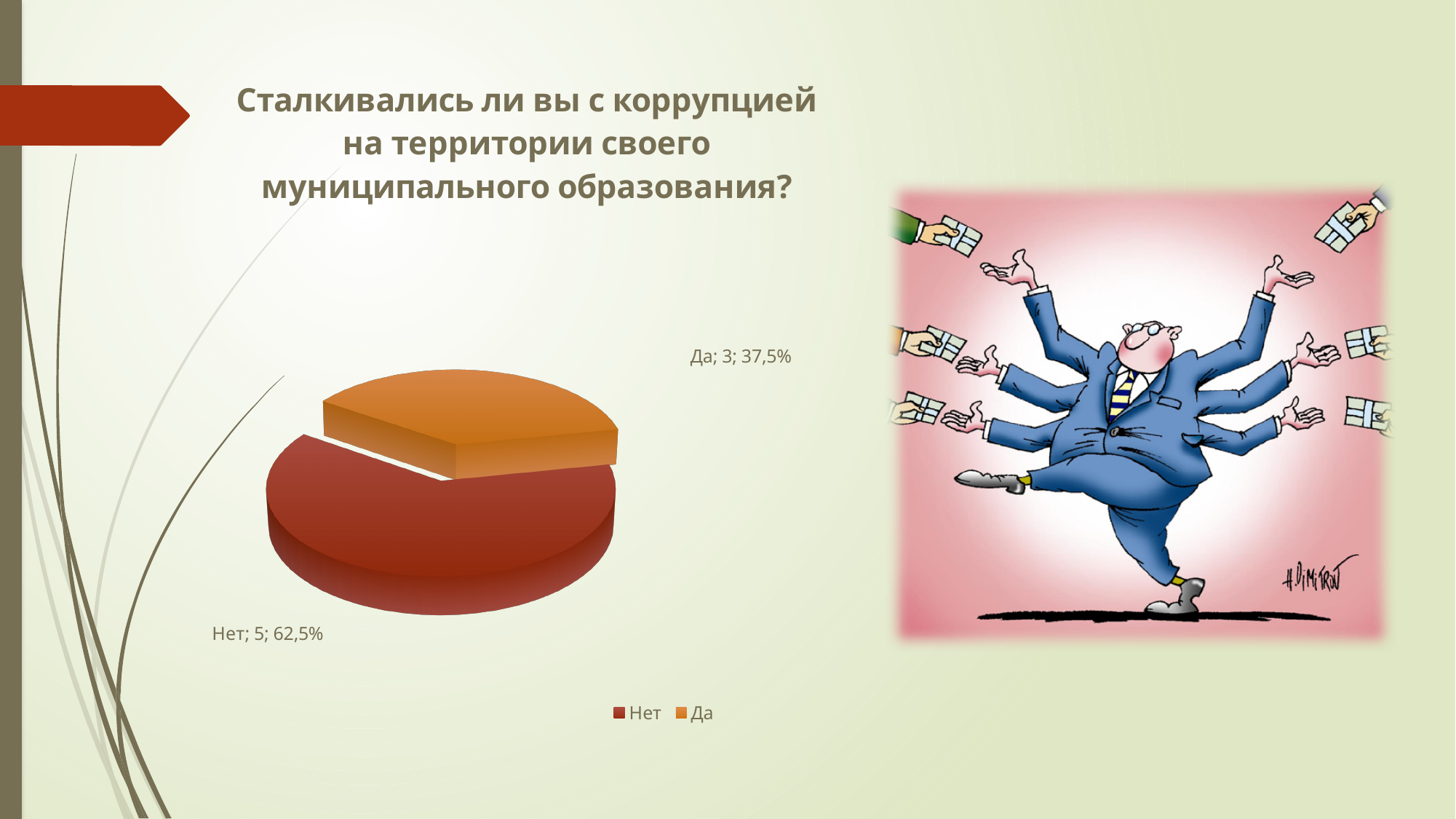
Which category has the smallest slice of the pie? Да How many categories does the pie chart have? 2 Which category has the largest slice of the pie? Нет How many respondents answered "Нет"? 5 What kind of chart is shown on the slide? pie chart What share of the pie does the "Нет" slice represent? 62,5% What is the total number of responses shown in the pie chart? 8 Which is larger, the "Да" slice or the "Нет" slice? Нет What is the difference between the number of "Нет" and "Да" responses? 2 What colour is the "Да" slice in the pie chart? orange How many respondents answered "Да"? 3 What share of the pie does the "Да" slice represent? 37,5%